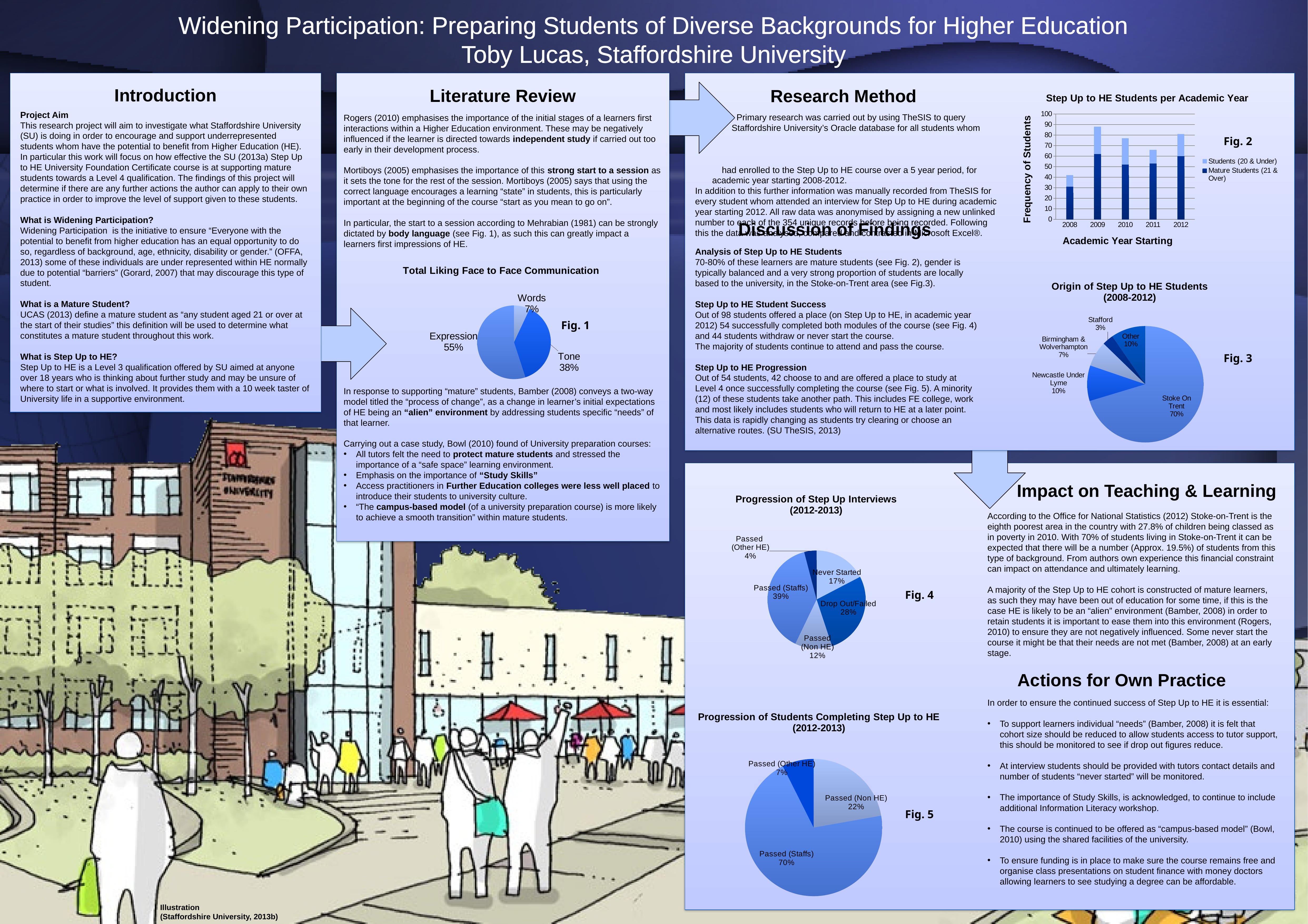
In the 'Origin of Step Up to HE Students (2008-2012)' pie chart (Fig. 3), what share is Stoke On Trent? 70% In the 'Progression of Students Completing Step Up to HE (2012-2013)' pie chart (Fig. 5), what share is Passed (Non HE)? 22% How many series does the legend of 'Step Up to HE Students per Academic Year' (Fig. 2) list? 2 In 'Step Up to HE Students per Academic Year' (Fig. 2), which academic year has the tallest bar? 2009 In the 'Total Liking Face to Face Communication' pie chart (Fig. 1), what share is Expression? 55% In the 'Origin of Step Up to HE Students (2008-2012)' pie chart (Fig. 3), which origin has the smallest share? Stafford In 'Step Up to HE Students per Academic Year' (Fig. 2), how many academic years are shown on the x axis? 5 In the 'Total Liking Face to Face Communication' pie chart (Fig. 1), what is the difference between the Tone and Words shares? 31% In the 'Progression of Step Up Interviews (2012-2013)' pie chart (Fig. 4), which is larger: Drop Out/Failed or Never Started? Drop Out/Failed In the 'Total Liking Face to Face Communication' pie chart (Fig. 1), which slice is the smallest? Words What kind of chart is 'Step Up to HE Students per Academic Year' (Fig. 2)? bar chart In 'Step Up to HE Students per Academic Year' (Fig. 2), is the total bar height for 2008 greater or less than 50? less